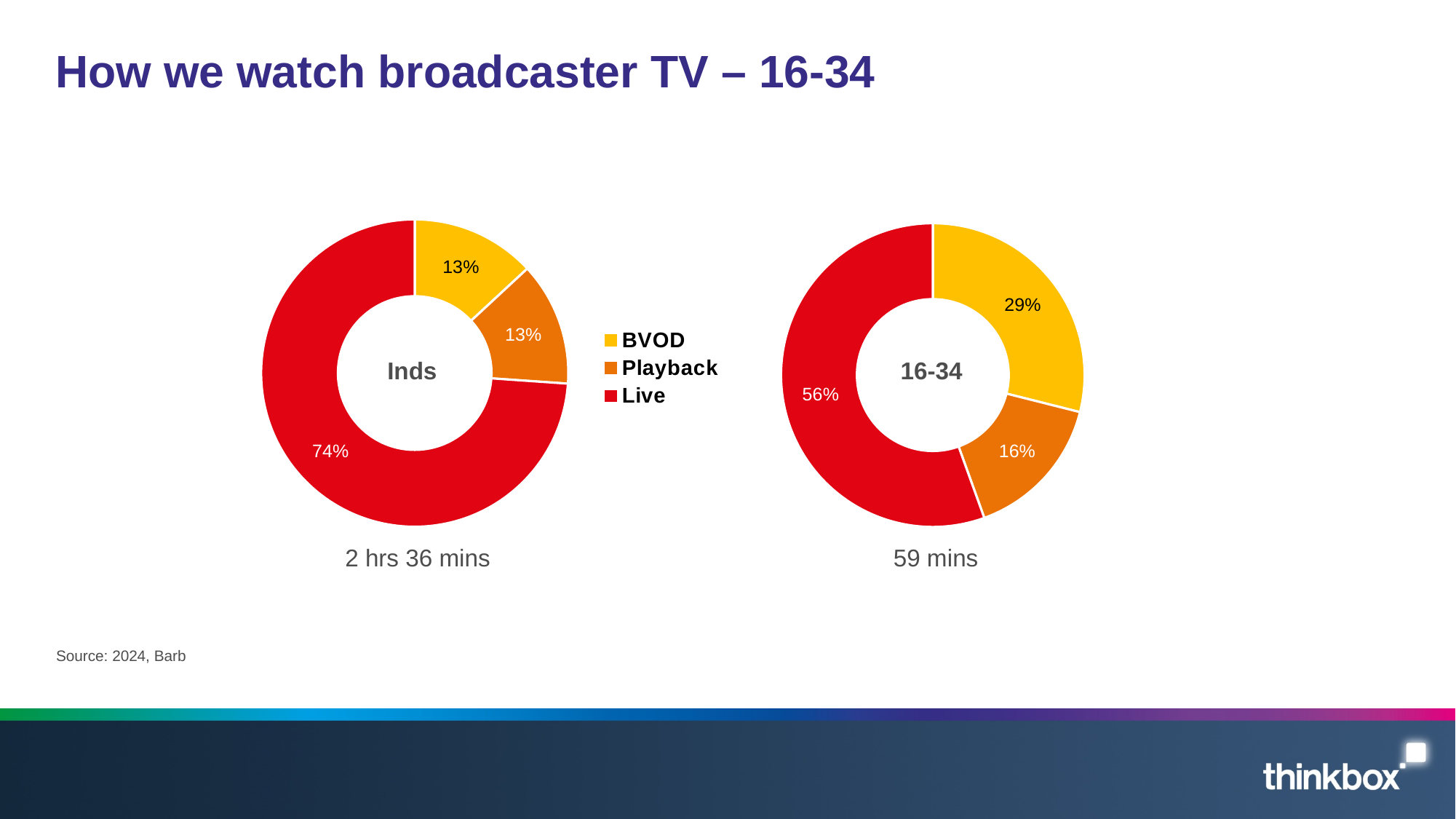
In the 16-34 donut chart, which category has the largest share? Live In the Inds donut chart, which category has the largest share? Live Which is larger: the BVOD share in the 16-34 chart or the BVOD share in the Inds chart? 16-34 How many series does the legend list? 3 What is the difference between the Live share in the Inds chart and the Live share in the 16-34 chart? 18% In the Inds donut chart, what share is BVOD? 13% In the 16-34 donut chart, what share is Playback? 16% In the 16-34 donut chart, which category has the smallest share? Playback What viewing time is shown below the 16-34 donut chart? 59 mins In the Inds donut chart, what share is Live? 74% What kind of chart is used on this slide? Donut (pie) chart In the 16-34 donut chart, what share is BVOD? 29%